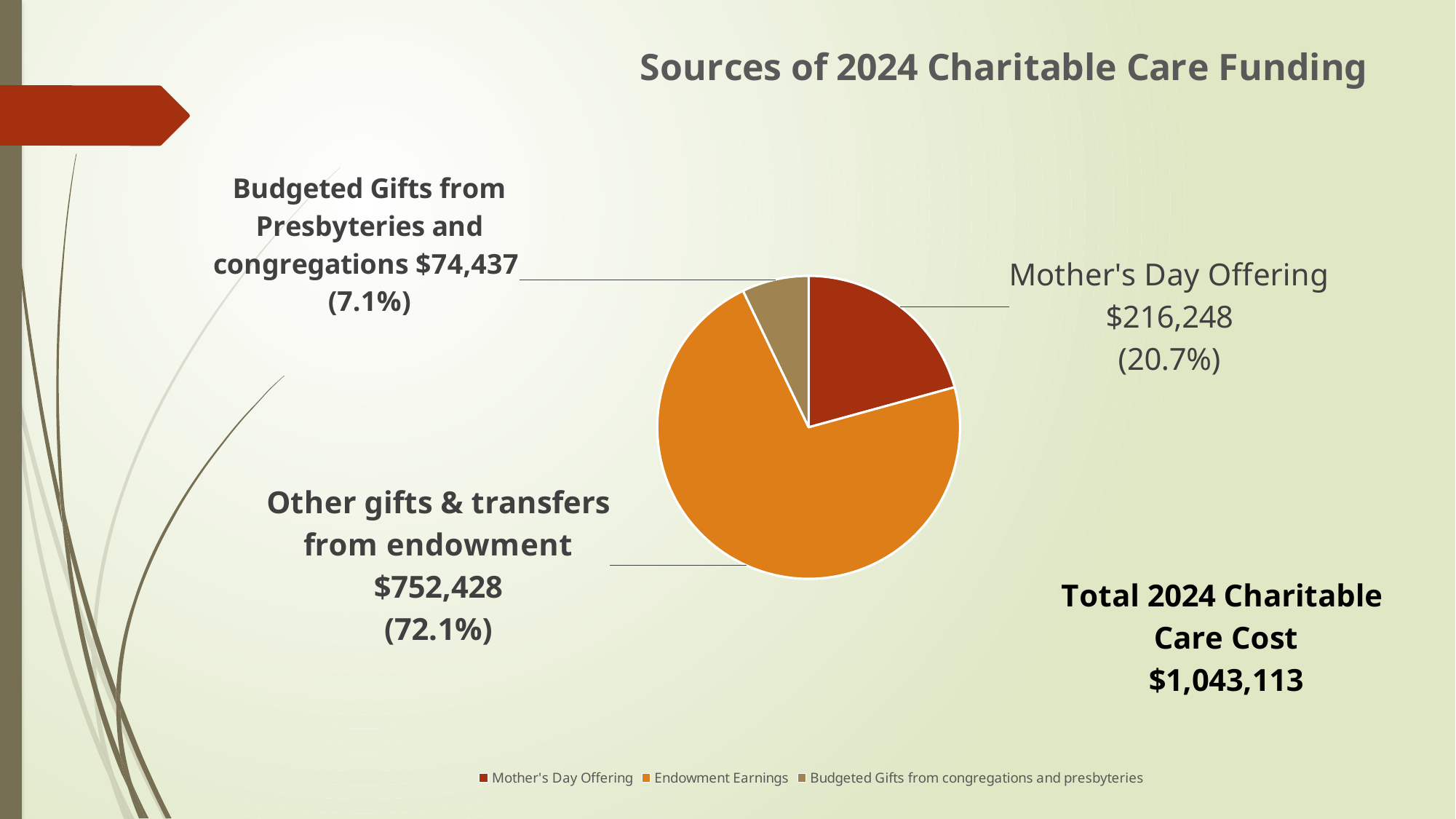
What is the value for Other gifts & transfers from endowment? $752,428 What is the value for Budgeted Gifts from Presbyteries and congregations? $74,437 What kind of chart is shown on the slide? Pie chart What share of the pie does Other gifts & transfers from endowment represent? 72.1% Which source is the smallest slice of the pie? Budgeted Gifts from Presbyteries and congregations What is the difference between Mother's Day Offering and Budgeted Gifts from Presbyteries and congregations? $141,811 Which source is the largest slice of the pie? Other gifts & transfers from endowment Which is larger, Mother's Day Offering or Budgeted Gifts from Presbyteries and congregations? Mother's Day Offering How many slices does the pie chart have? 3 What share of the pie does Mother's Day Offering represent? 20.7% What is the title of the chart? Sources of 2024 Charitable Care Funding What is the value for Mother's Day Offering? $216,248